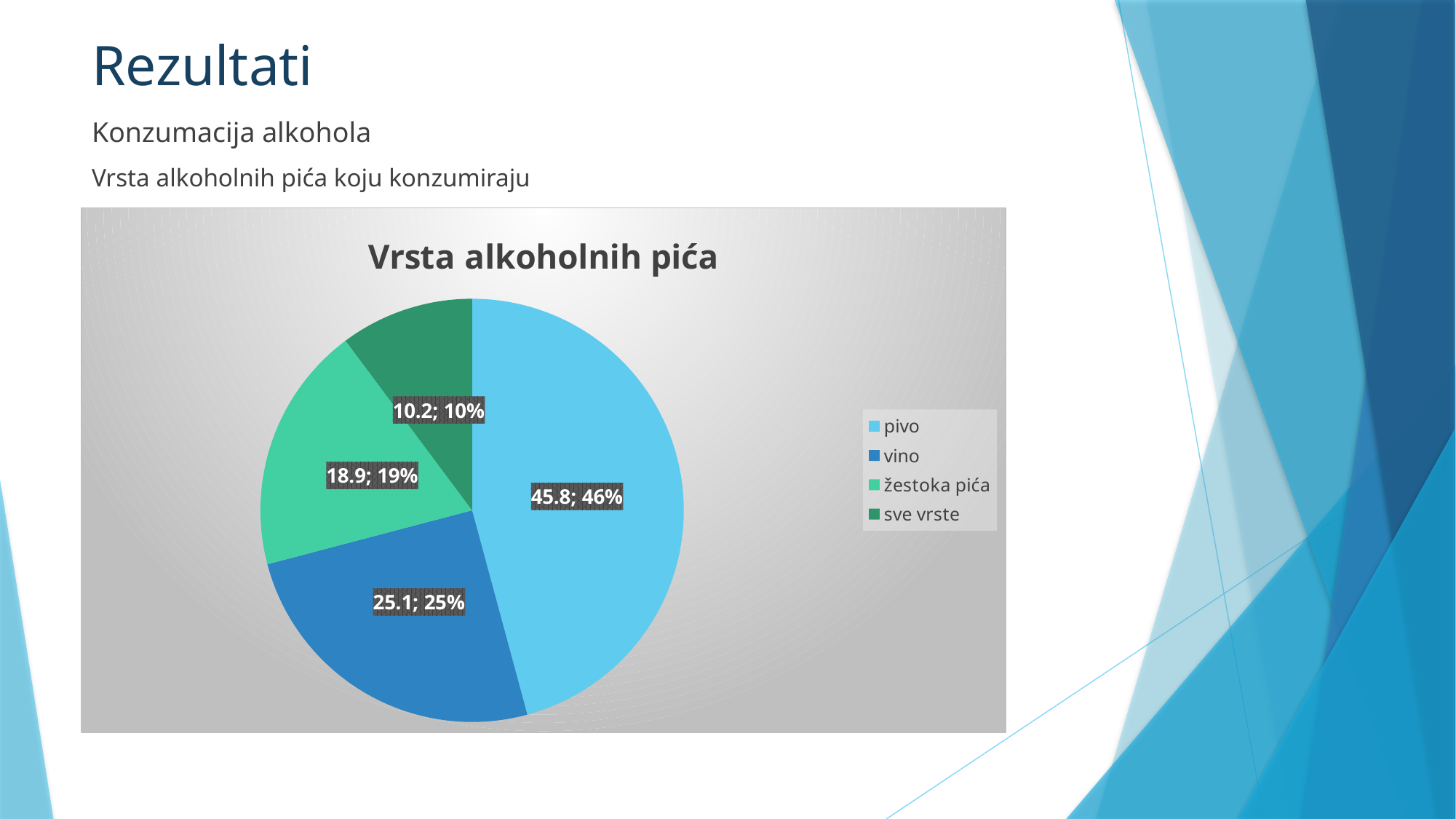
What value is shown for the žestoka pića slice? 18.9 Which category has the smallest slice of the pie? sve vrste How many slices does the pie chart have? 4 Which is larger, the value for vino or the value for žestoka pića? vino What value is shown for the sve vrste slice? 10.2 Which category has the largest slice of the pie? pivo What value is shown for the vino slice? 25.1 What is the title of the chart? Vrsta alkoholnih pića What value is shown for the pivo slice? 45.8 What kind of chart is shown on the slide? pie chart What percentage share of the pie does vino have? 25% What percentage share of the pie does žestoka pića have? 19%